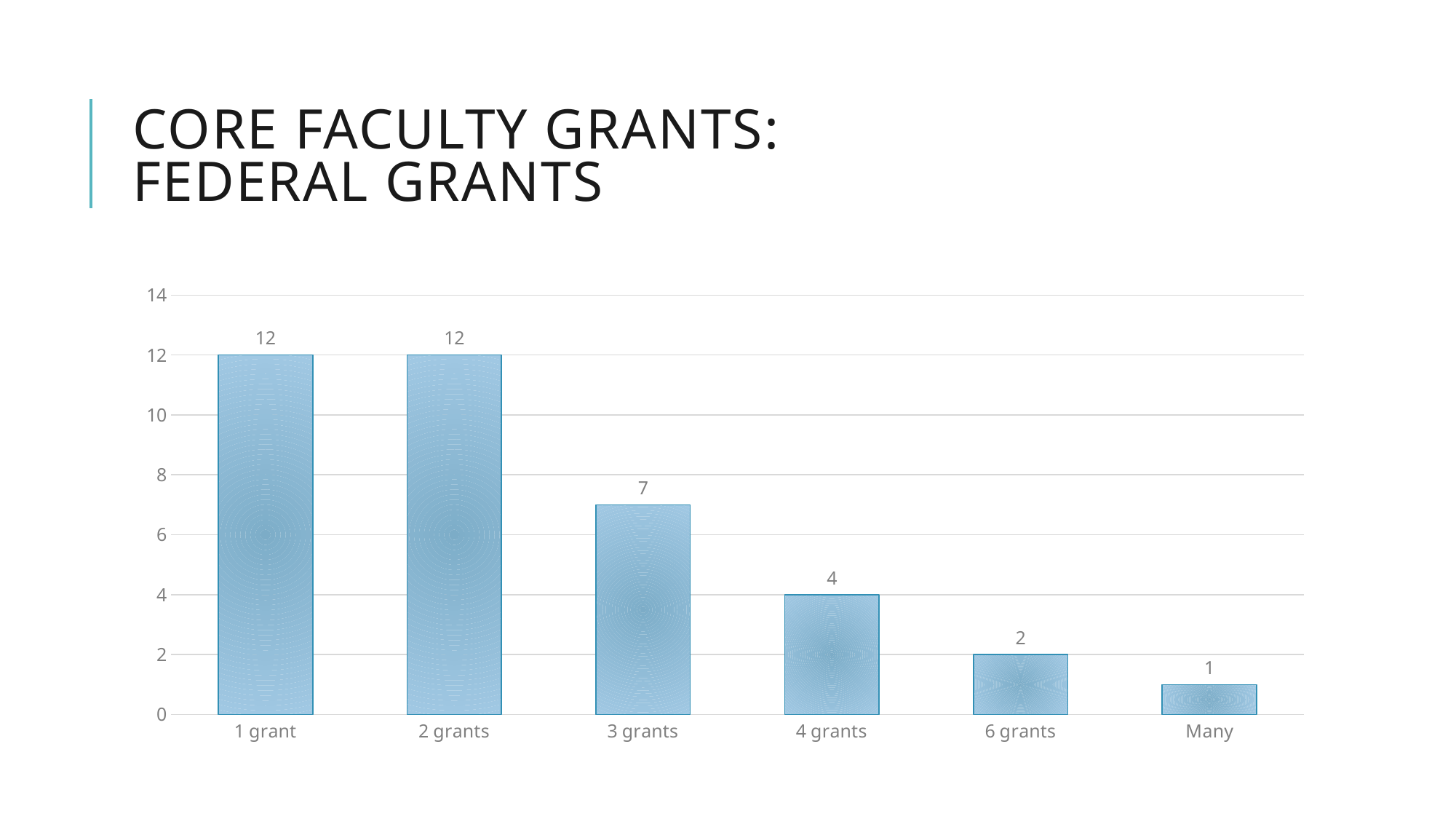
What is the value for 4 grants? 4 Which category has the lowest value? Many What is the value for 6 grants? 2 Is the value for 2 grants greater or less than 10? greater How many categories are shown on the x axis? 6 What kind of chart is shown on the slide? bar chart What is the value for Many? 1 What is the difference between the values for 4 grants and 6 grants? 2 Do the values rise or fall from left to right along the x axis? fall What is the difference between the values for 1 grant and 3 grants? 5 What is the value for 3 grants? 7 Which is larger, the value for 3 grants or the value for 4 grants? 3 grants